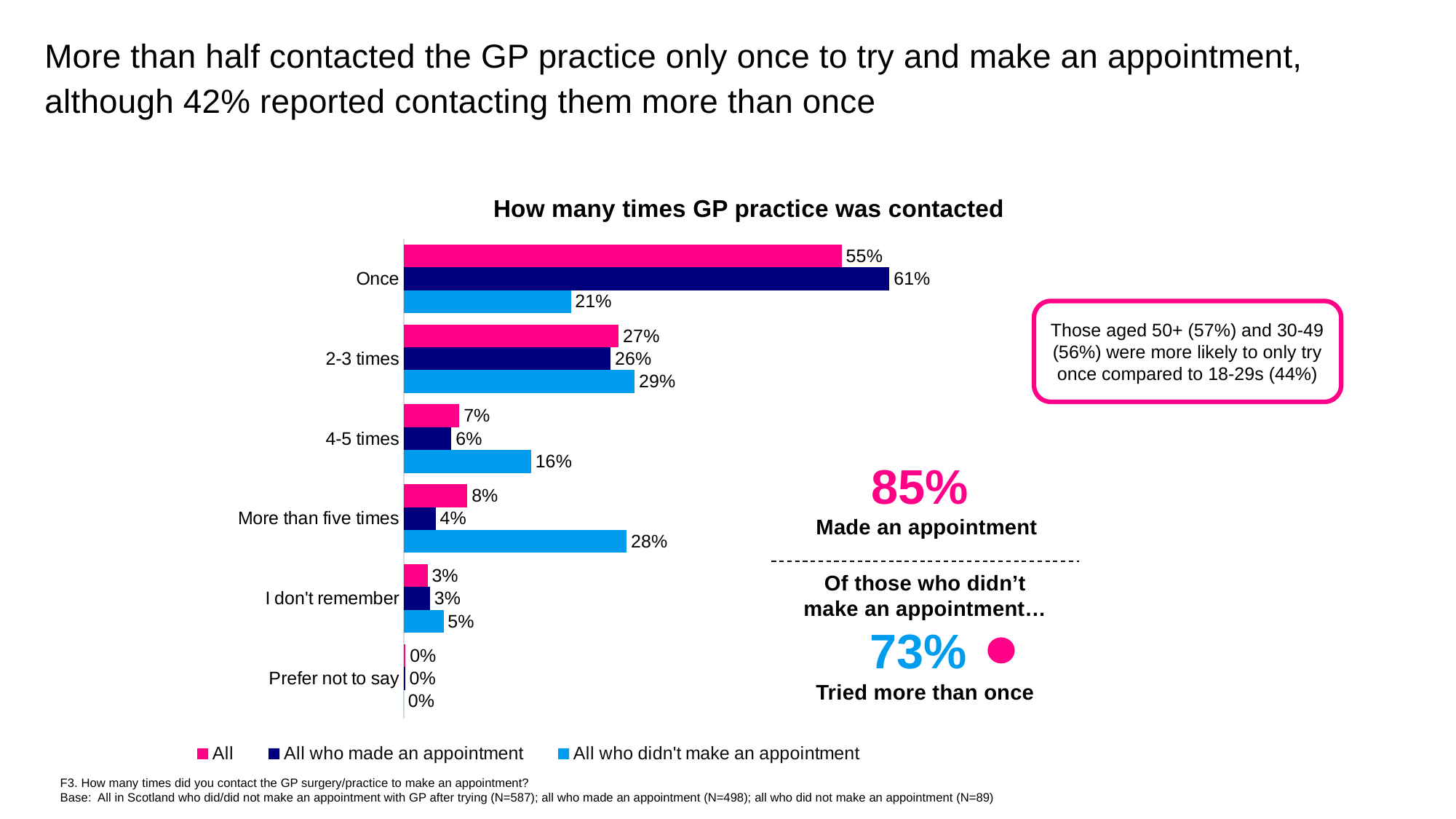
What is the value for '2-3 times' in the 'All who didn't make an appointment' series? 29% Which colour represents the 'All' series? Pink How many categories are shown on the chart? 6 What is the value for 'Once' in the 'All' series? 55% What is the title of the chart? How many times GP practice was contacted How many series does the legend list? 3 Which category has the lowest value in the 'All who didn't make an appointment' series? Prefer not to say What kind of chart is shown? Bar chart What is the value for 'More than five times' in the 'All who made an appointment' series? 4% For 'More than five times', which series has the larger value: 'All' or 'All who didn't make an appointment'? All who didn't make an appointment Which category has the highest value in the 'All who made an appointment' series? Once What is the difference between the 'All who made an appointment' and 'All who didn't make an appointment' values for 'Once'? 40%